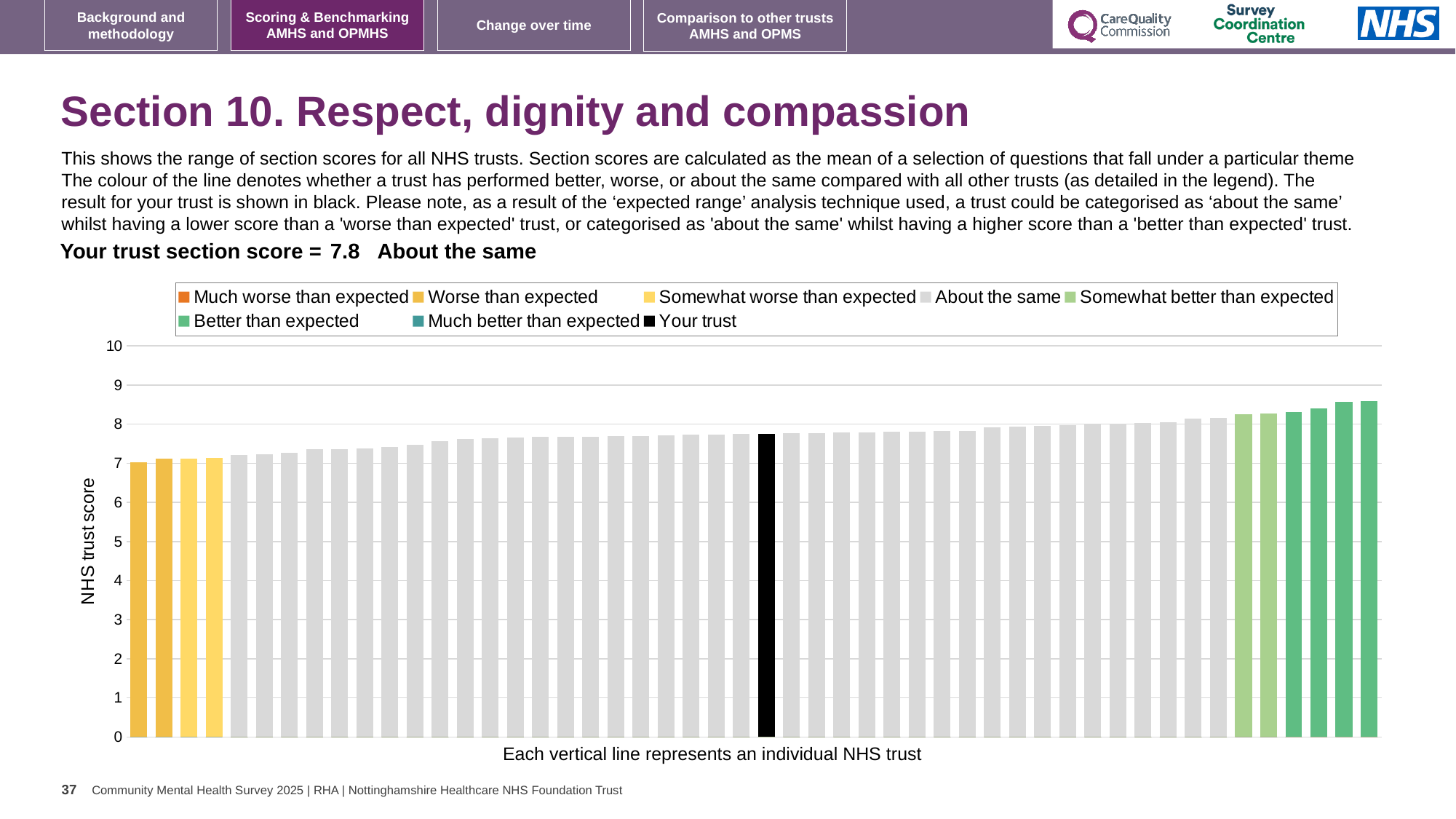
Which is larger: the value for your trust (the black bar) or the value of the leftmost bar? your trust What is the label below the horizontal axis of the chart? Each vertical line represents an individual NHS trust Which category is your trust's section score placed in? About the same Do the bar values rise or fall from left to right along the x axis? rise Is the value of the shortest bar in the chart greater or less than 6? greater Is the value of the tallest bar in the chart greater or less than 8? greater What is the section score for your trust shown on the slide? 7.8 What kind of chart is shown on the slide? bar chart How many entries does the chart legend list? 8 Is the value for your trust (the black bar) greater or less than 7? greater What is the label on the vertical axis of the chart? NHS trust score